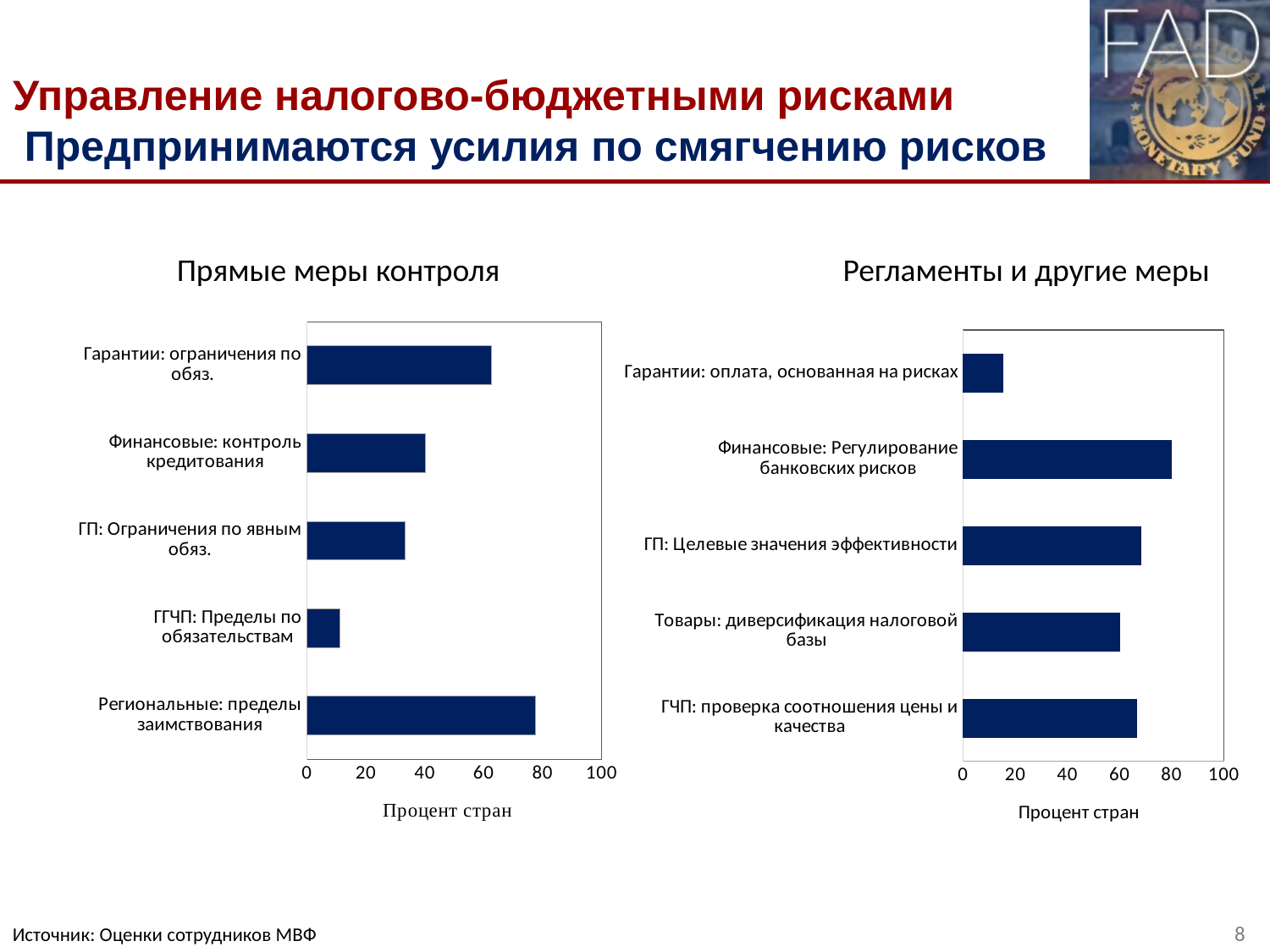
In the 'Прямые меры контроля' chart, which category has the lowest value? ГГЧП: Пределы по обязательствам In the 'Регламенты и другие меры' chart, is the value for 'Товары: диверсификация налоговой базы' greater or less than 40? greater In the 'Регламенты и другие меры' chart, is the value for 'Гарантии: оплата, основанная на рисках' greater or less than 20? less In the 'Регламенты и другие меры' chart, which category has the highest value? Финансовые: Регулирование банковских рисков What is the x-axis title of the 'Регламенты и другие меры' chart? Процент стран How many categories are shown in the 'Прямые меры контроля' chart? 5 In the 'Прямые меры контроля' chart, which is larger: 'Финансовые: контроль кредитования' or 'ГП: Ограничения по явным обяз.'? Финансовые: контроль кредитования In the 'Регламенты и другие меры' chart, which category has the lowest value? Гарантии: оплата, основанная на рисках In the 'Прямые меры контроля' chart, is the value for 'ГГЧП: Пределы по обязательствам' greater or less than 20? less What kind of chart is the 'Прямые меры контроля' chart? bar chart In the 'Прямые меры контроля' chart, which category has the highest value? Региональные: пределы заимствования